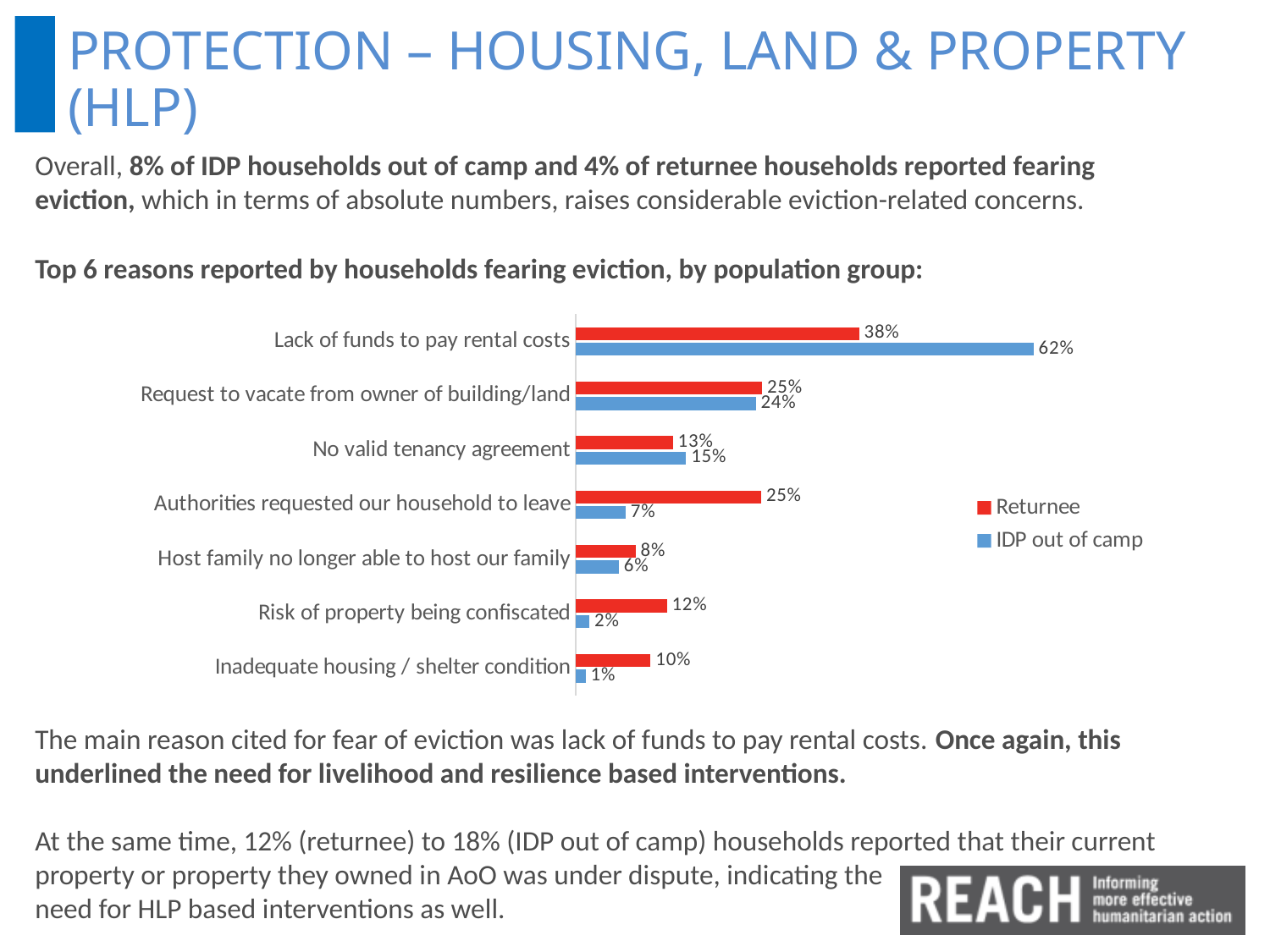
How many series does the chart legend list? 2 How many reasons (categories) are shown in the chart? 7 For 'No valid tenancy agreement', which group has the larger value, returnee or IDP out of camp? IDP out of camp For 'Risk of property being confiscated', which group has the larger value, returnee or IDP out of camp? Returnee What percentage of IDP out of camp households reported lack of funds to pay rental costs as a reason for fearing eviction? 62% What is the difference between the returnee and IDP out of camp values for 'Authorities requested our household to leave'? 18 percentage points What type of chart is shown on the slide? Bar chart Which reason has the highest value for IDP out of camp households? Lack of funds to pay rental costs What is the value for IDP out of camp households for 'Risk of property being confiscated'? 2% Which reason has the lowest value for IDP out of camp households? Inadequate housing / shelter condition What percentage of returnee households reported that authorities requested their household to leave? 25% What is the difference between the IDP out of camp and returnee values for 'Lack of funds to pay rental costs'? 24 percentage points